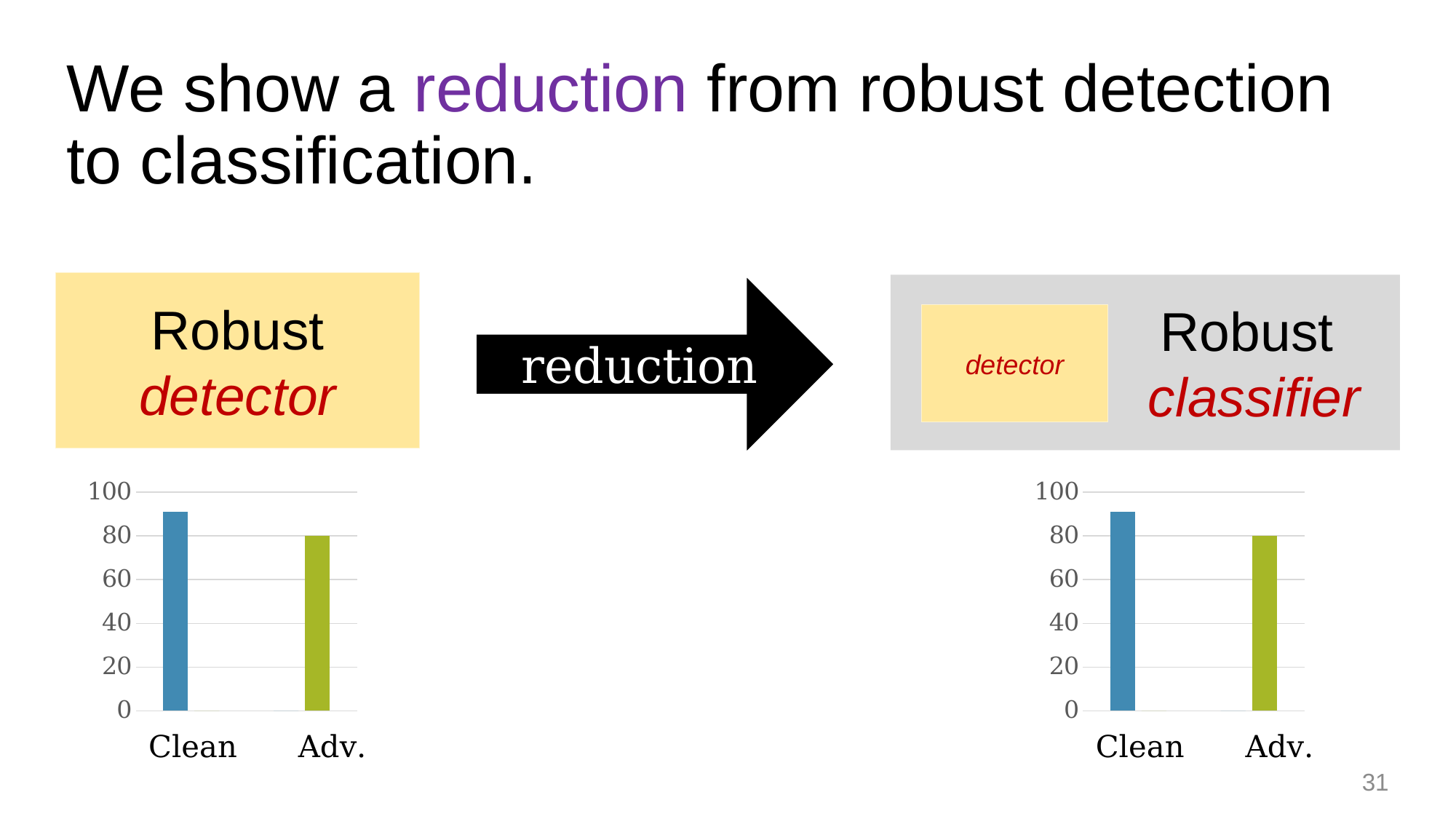
In the right chart under "Robust classifier", which category has the lowest value? Adv. In the left chart under "Robust detector", which category has the highest value? Clean In the left chart under "Robust detector", which is larger, Clean or Adv.? Clean In the left chart under "Robust detector", is the value for Clean greater or less than 80? greater In the left chart under "Robust detector", what is the value for Adv.? 80 What kind of chart is the left chart under "Robust detector"? Bar chart How many categories are shown in the right chart under "Robust classifier"? 2 In the right chart under "Robust classifier", is the value for Clean greater or less than 100? less What is the highest value shown on the y axis of the right chart under "Robust classifier"? 100 In the right chart under "Robust classifier", what is the value for Adv.? 80 In the right chart under "Robust classifier", do the values rise or fall from Clean to Adv.? Fall In the left chart under "Robust detector", what colour is the Adv. bar? Green